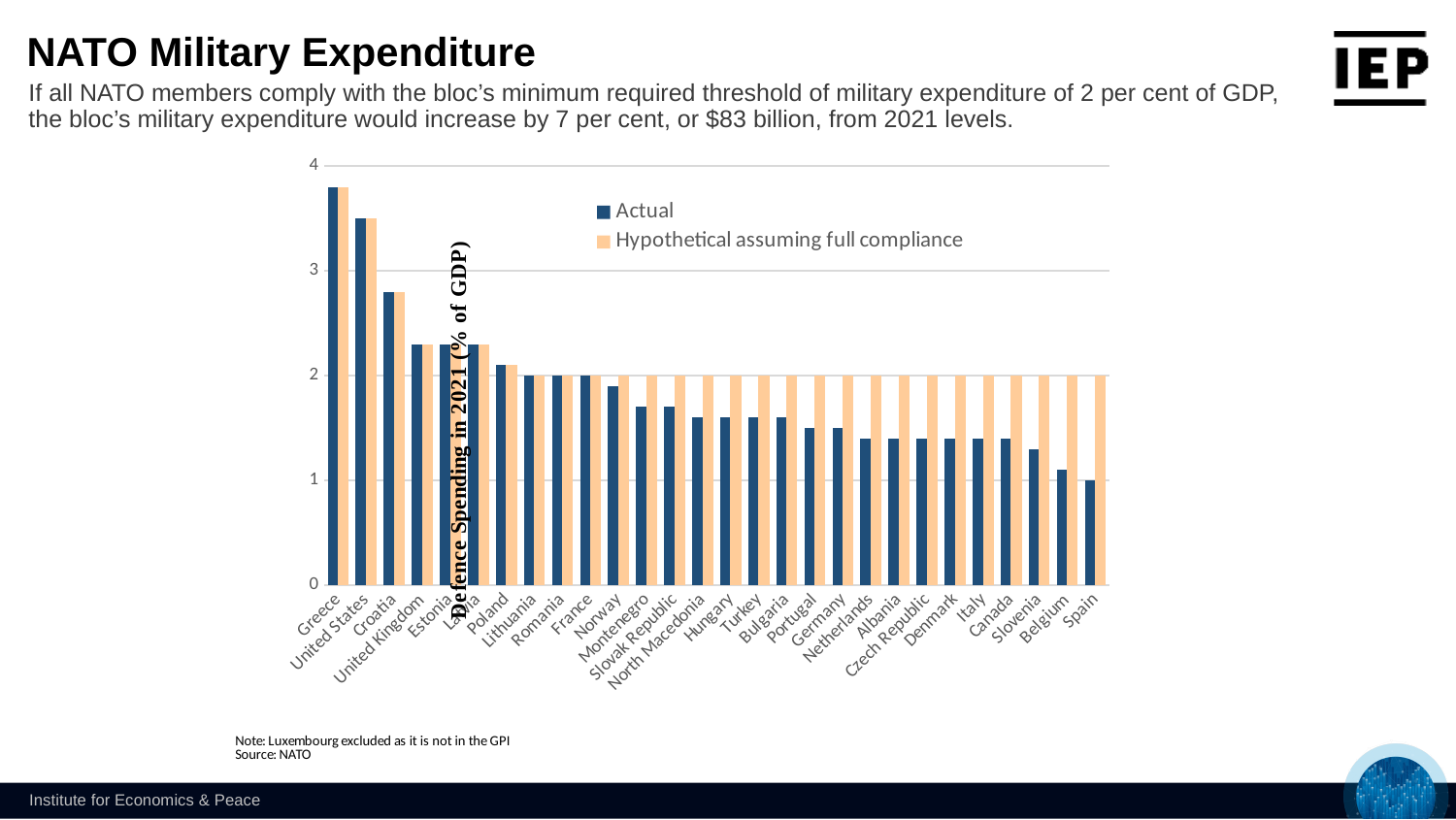
Which country has the lowest Actual defence spending as a share of GDP? Spain Which has the larger Actual value, Slovenia or Belgium? Slovenia Which country has the highest Actual defence spending as a share of GDP? Greece What are the two series named in the legend? Actual; Hypothetical assuming full compliance How many series does the legend list? 2 Is the Actual value for Croatia greater or less than 3? less Is the Actual value for Norway greater or less than 2? less Which has the larger Actual value, Greece or United States? Greece What type of chart is shown on the slide? bar chart Do the Actual values rise or fall moving from left to right along the x axis? fall Is the Actual value for Germany greater or less than 2? less